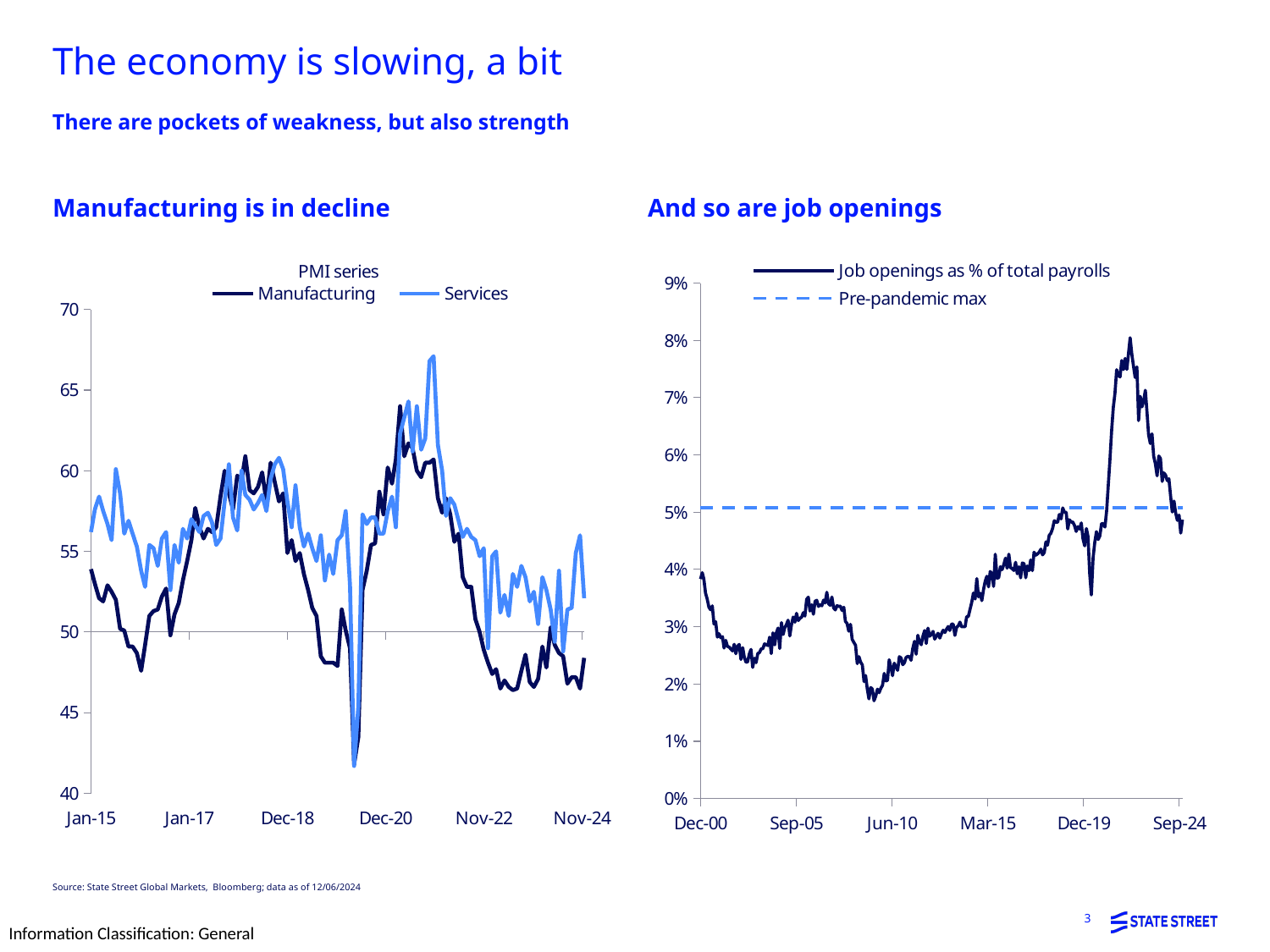
In the right chart, what does the dashed line represent according to the legend? Pre-pandemic max In the right chart, is the lowest value of job openings as % of total payrolls greater or less than 2%? less How many series does the legend of the right chart ('And so are job openings') list? 2 In the left chart, is the lowest Manufacturing value (around 2020) greater or less than 45? less In the right chart, does the job openings series rise or fall from its peak (around 2022) to Sep-24? fall In the left chart, is the peak Services value (around 2021) greater or less than 65? greater What kind of chart is the 'And so are job openings' chart on the right? line chart What are the two series named in the legend of the left chart (PMI series)? Manufacturing and Services What kind of chart is the 'Manufacturing is in decline' chart on the left? line chart How many series does the legend of the left chart (PMI series) list? 2